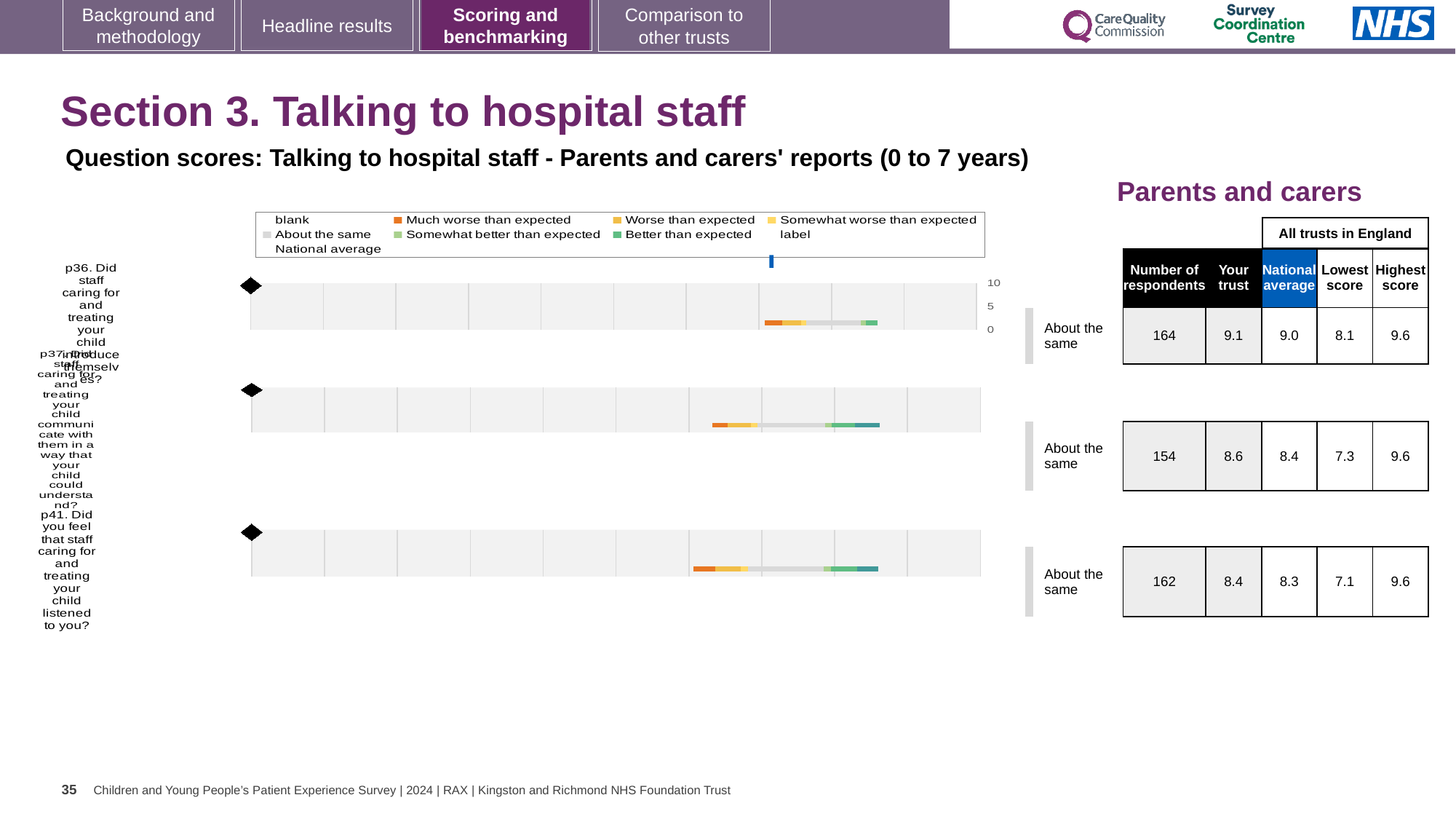
What is the national average score for p37 (Did staff communicate with your child in a way they could understand)? 8.4 Is the 'Your trust' score for p37 higher or lower than the national average for p37? higher Which question has the highest 'Your trust' score? p36 How many entries does the chart legend list? 9 How many respondents answered p36? 164 How many questions (bars) are plotted in the chart? 3 What kind of chart is used to show the question scores on this slide? bar chart What is the difference between the 'Your trust' score for p36 and for p41? 0.7 What is the 'Your trust' score for p36 (Did staff caring for and treating your child introduce themselves)? 9.1 Is the 'Your trust' score for p36 greater or less than 5 on the chart axis? greater What is the lowest score among all trusts in England for p41 (Did you feel that staff listened to you)? 7.1 Which question has the fewest respondents? p37